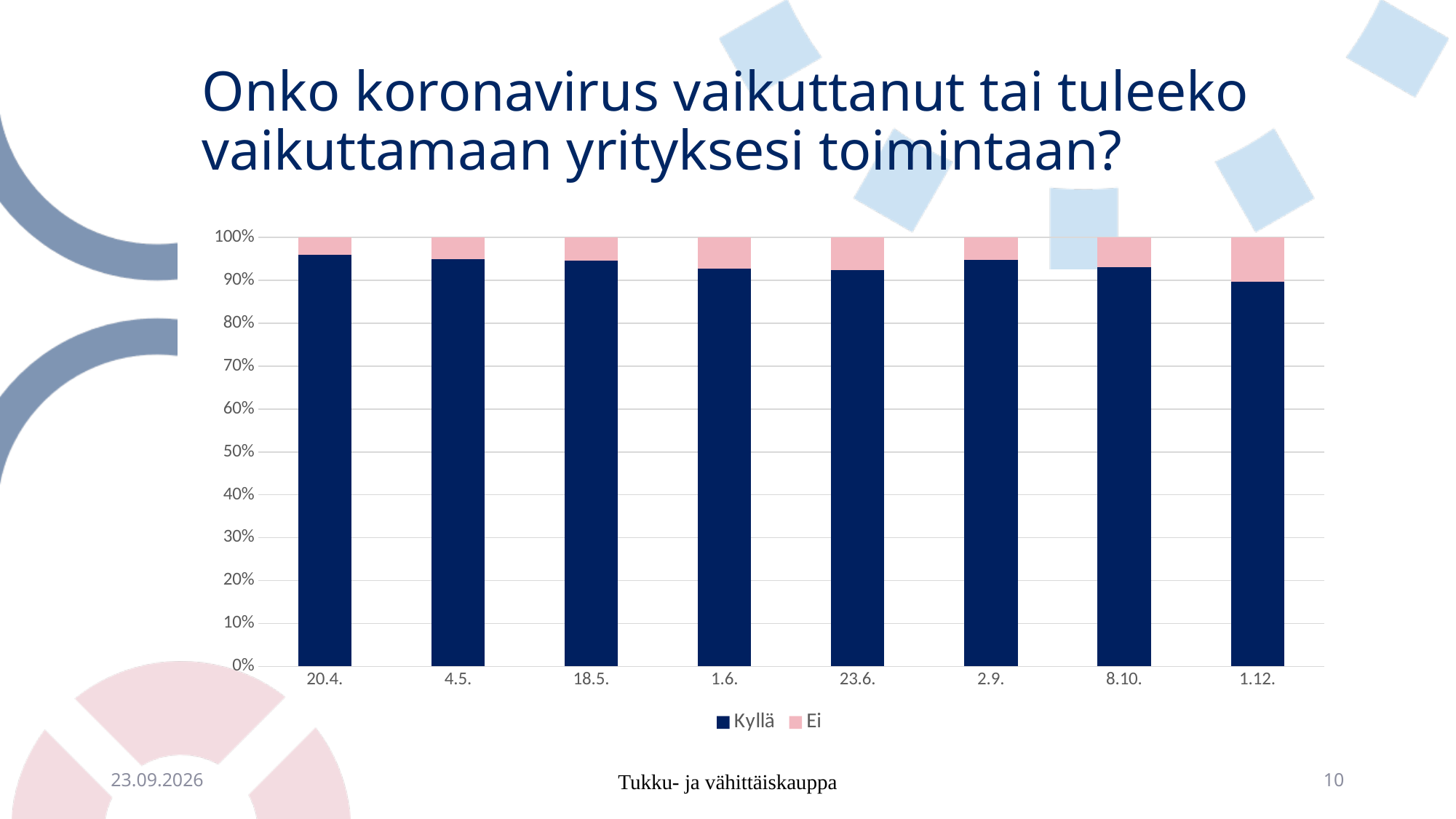
Which colour represents the Kyllä series? dark blue How many series does the legend list? 2 How many dates (categories) are shown on the x axis? 8 On which date is the Ei share highest? 1.12. Is the Kyllä value for 20.4. greater or less than 90%? greater Which is larger, the Kyllä share for 20.4. or for 1.12.? 20.4. Is the Kyllä value for 1.12. greater or less than 95%? less What is the total height of each stacked bar? 100% Is the Kyllä value for 1.6. greater or less than 90%? greater On which date is the Kyllä share lowest? 1.12. What kind of chart is shown on the slide? stacked bar chart What are the two series named in the legend? Kyllä and Ei